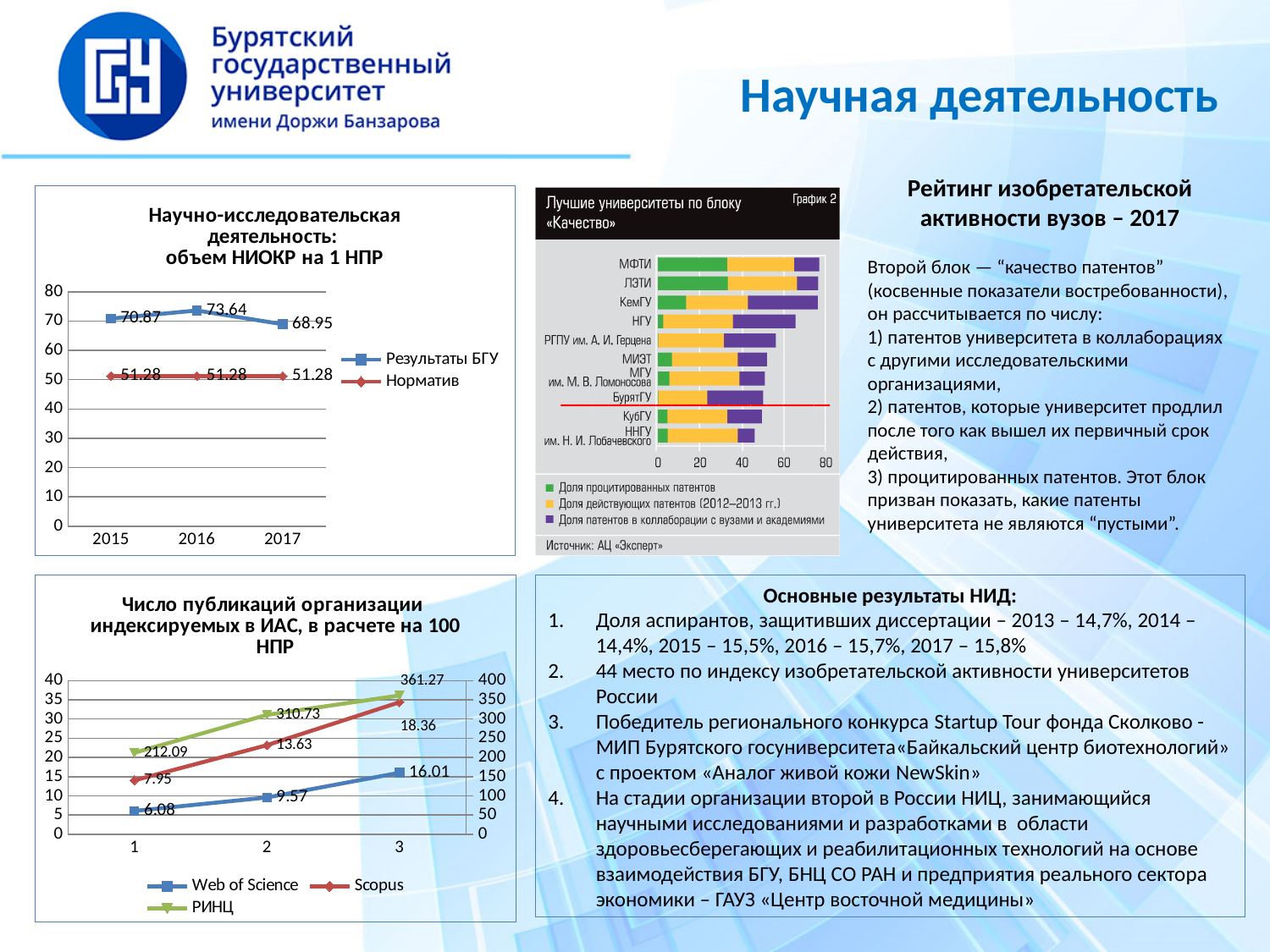
On the chart titled «Научно-исследовательская деятельность: объем НИОКР на 1 НПР», what is the value of Результаты БГУ for 2016? 73.64 On the chart titled «Научно-исследовательская деятельность: объем НИОКР на 1 НПР», what is the value of Норматив for 2017? 51.28 On the chart titled «Научно-исследовательская деятельность: объем НИОКР на 1 НПР», what kind of chart is it? Line chart On the chart titled «Научно-исследовательская деятельность: объем НИОКР на 1 НПР», in which year is Результаты БГУ lowest? 2017 On the chart titled «Число публикаций организации индексируемых в ИАС, в расчете на 100 НПР», which is larger at point 1: Web of Science or Scopus? Scopus On the chart titled «Научно-исследовательская деятельность: объем НИОКР на 1 НПР», what is the difference between Результаты БГУ and Норматив in 2015? 19.59 On the chart titled «Научно-исследовательская деятельность: объем НИОКР на 1 НПР», how many series does the legend list? 2 On the chart titled «Число публикаций организации индексируемых в ИАС, в расчете на 100 НПР», how many series does the legend list? 3 On the chart titled «Число публикаций организации индексируемых в ИАС, в расчете на 100 НПР», what is the Scopus value at point 2? 13.63 On the chart titled «Лучшие университеты по блоку «Качество»», how many universities are listed on the vertical axis? 10 On the chart titled «Число публикаций организации индексируемых в ИАС, в расчете на 100 НПР», what is the РИНЦ value at point 3? 361.27 On the chart titled «Число публикаций организации индексируемых в ИАС, в расчете на 100 НПР», does the Web of Science series rise or fall from point 1 to point 3? Rise